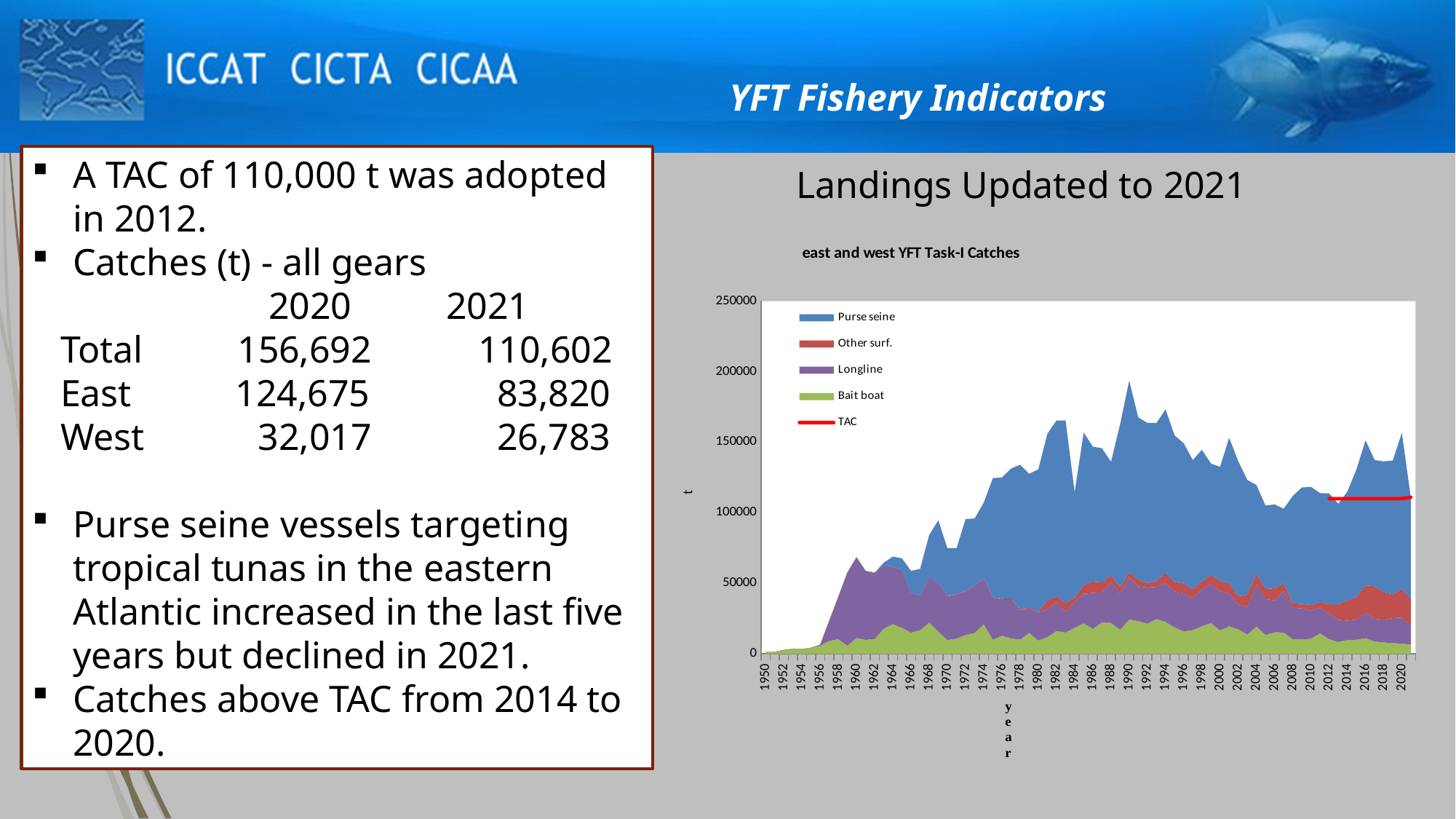
Is the total catch in 1970 greater or less than 150000? less What is the title of the chart on the slide? east and west YFT Task-I Catches Is the total catch in 2020 greater or less than 100000? greater Which year has the lowest total catch, 1950 or 2000? 1950 Do total catches rise or fall between 1950 and 1990? rise Is the total catch in 1990 greater or less than 150000? greater What kind of chart is shown on the slide? area chart Which legend entry is drawn as a red line rather than a filled area? TAC How many entries does the chart's legend list? 5 Is the total catch in 1990 larger or smaller than in 2010? larger In which year does the total catch reach its highest point? 1990